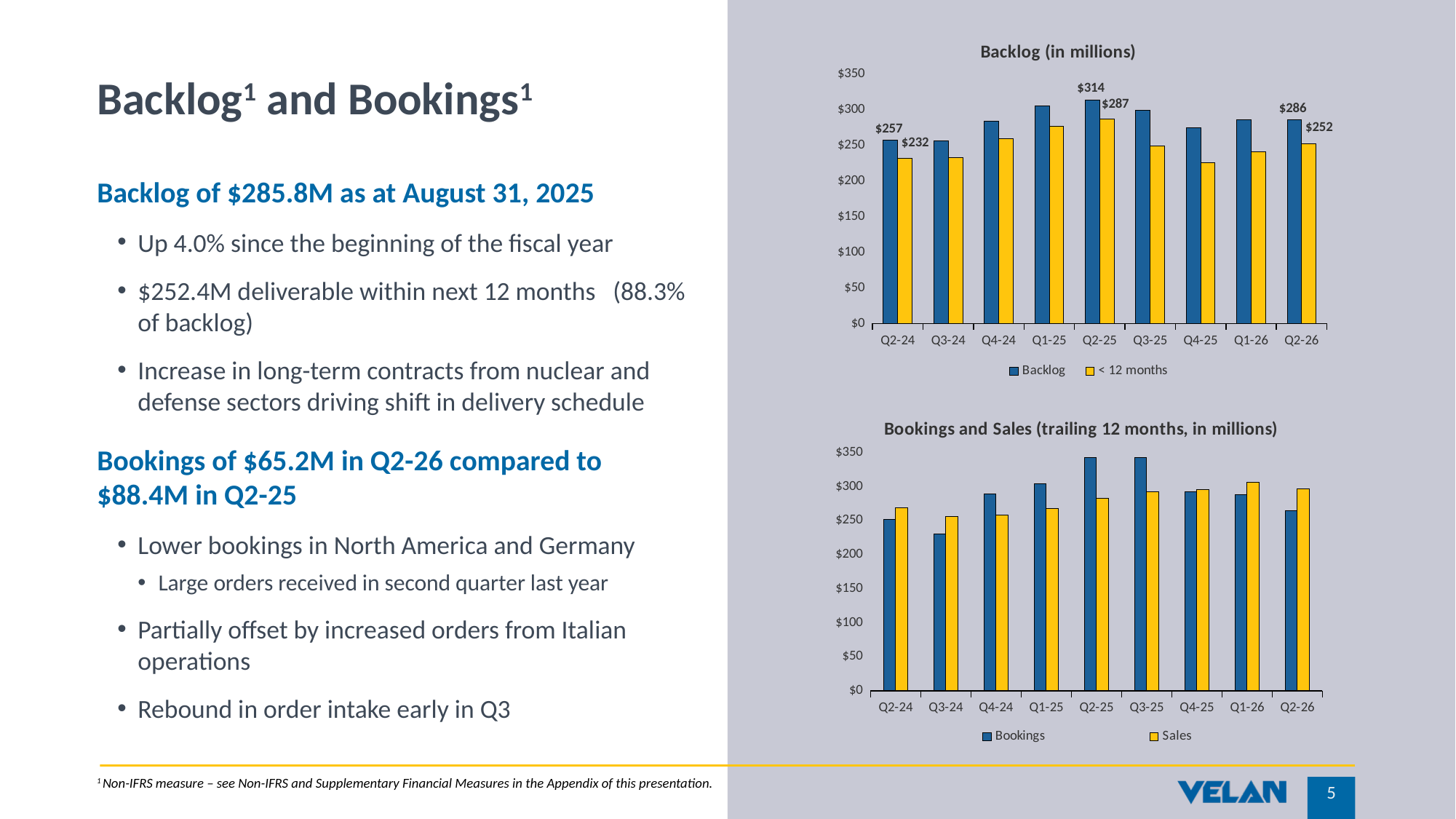
How many quarters are shown on the x axis of the Backlog (in millions) chart? 9 How many series does the legend of the Backlog (in millions) chart list? 2 In the Bookings and Sales chart, is the Bookings value for Q3-24 greater or less than $250? less In the Backlog (in millions) chart, what is the difference between the Backlog and < 12 months values for Q2-24? $25 In the Backlog (in millions) chart, which quarter has the highest Backlog bar? Q2-25 In the Bookings and Sales chart, which is larger for Q2-25, Bookings or Sales? Bookings In the Backlog (in millions) chart, what is the < 12 months value for Q2-26? $252 In the Backlog (in millions) chart, what is the Backlog value for Q2-25? $314 In the Bookings and Sales chart, which quarter has the lowest Bookings bar? Q3-24 In the Backlog (in millions) chart, how much lower is the Q2-26 Backlog than the Q2-25 Backlog? $28 What type of chart is the Bookings and Sales (trailing 12 months, in millions) chart? Bar chart In the Bookings and Sales chart, is the Sales value for Q1-26 greater or less than $300? greater